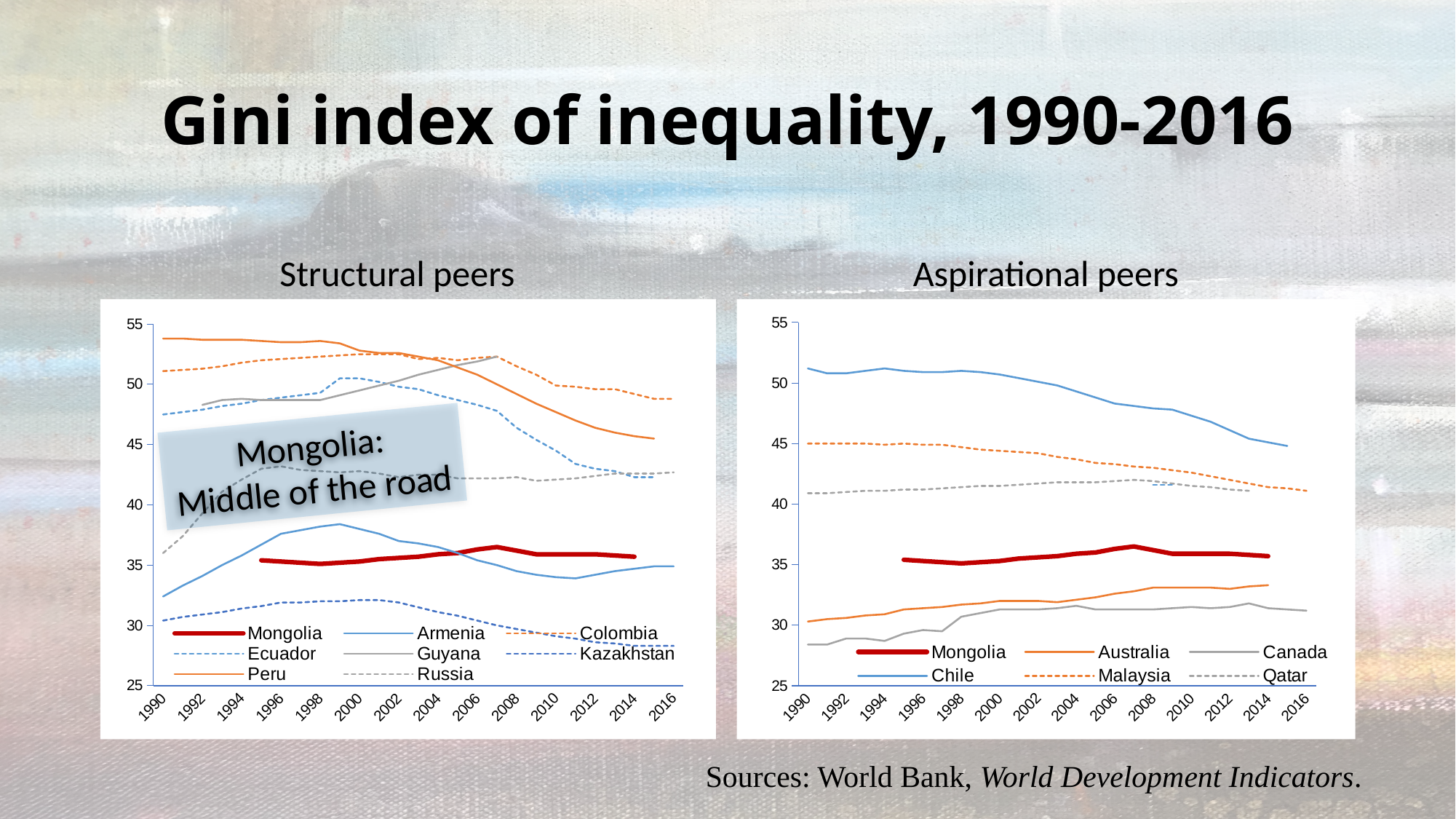
In the Structural peers chart, which is higher in 1990, Peru or Armenia? Peru How many series does the legend of the Aspirational peers chart list? 6 In the Aspirational peers chart, is the value for Malaysia in 2016 greater or less than 45? less In the Aspirational peers chart, is the value for Chile in 1990 greater or less than 50? greater In the Aspirational peers chart, does the value for Chile rise or fall from 1990 to 2016? fall How many series does the legend of the Structural peers chart list? 8 What kind of chart is the Structural peers chart? line chart In the Aspirational peers chart, is the value for Canada in 1990 greater or less than 30? less In the Aspirational peers chart, does the value for Australia rise or fall from 1990 to 2016? rise